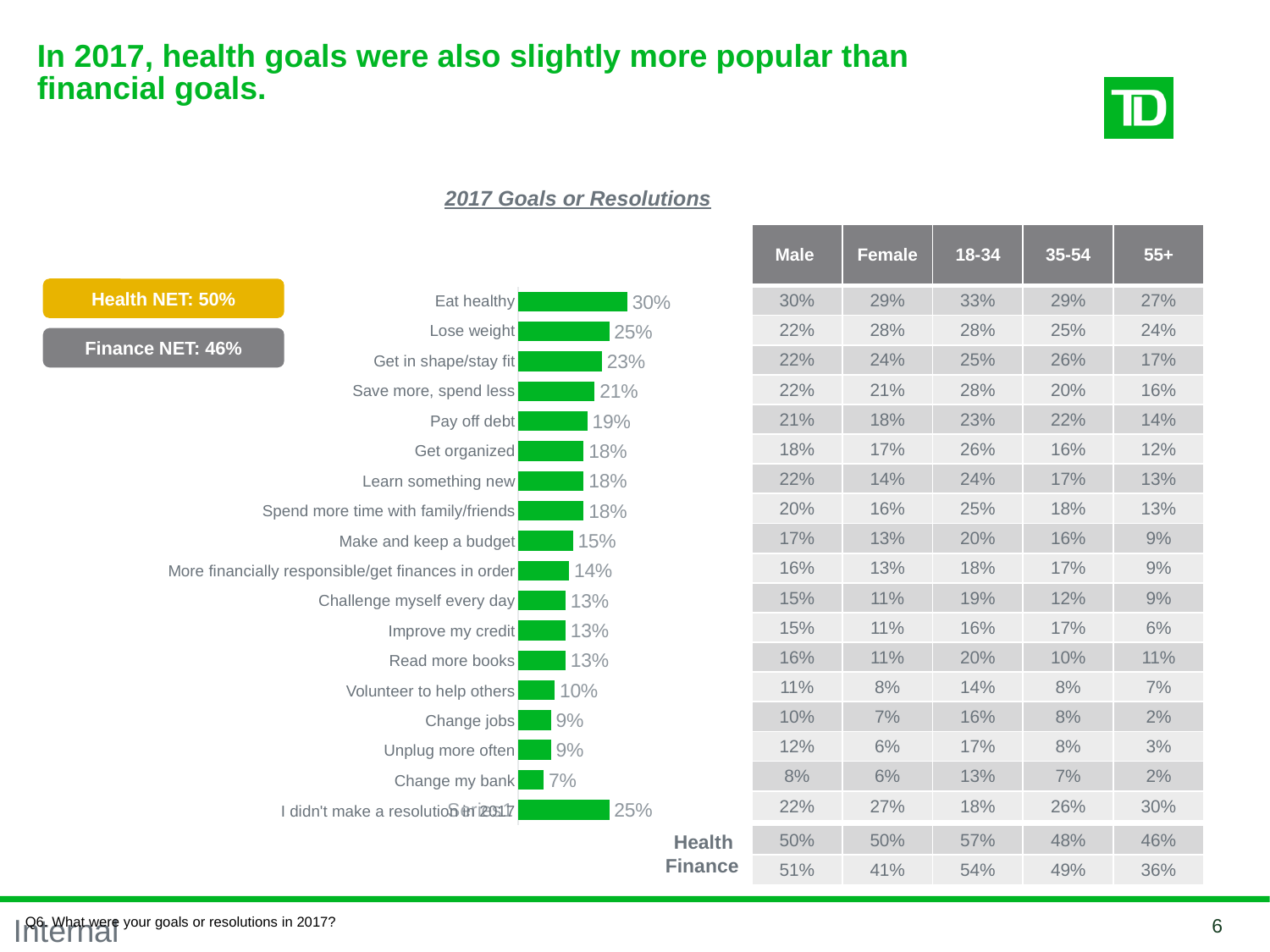
What is the value for 'I didn't make a resolution in 2017'? 25% What kind of chart is shown on the slide? bar chart What colour are the bars in the chart? green Which goal has the lowest value in the chart? Change my bank What is the difference between the values for 'Eat healthy' and 'Lose weight'? 5 percentage points What is the title of the chart? 2017 Goals or Resolutions What percentage of respondents said their goal was to eat healthy? 30% Which is larger, the value for 'Save more, spend less' or the value for 'Make and keep a budget'? Save more, spend less What is the difference between the values for 'Get in shape/stay fit' and 'Change my bank'? 16 percentage points Which goal has the highest value in the chart? Eat healthy What is the value for 'Pay off debt'? 19% How many categories are plotted in the bar chart? 18